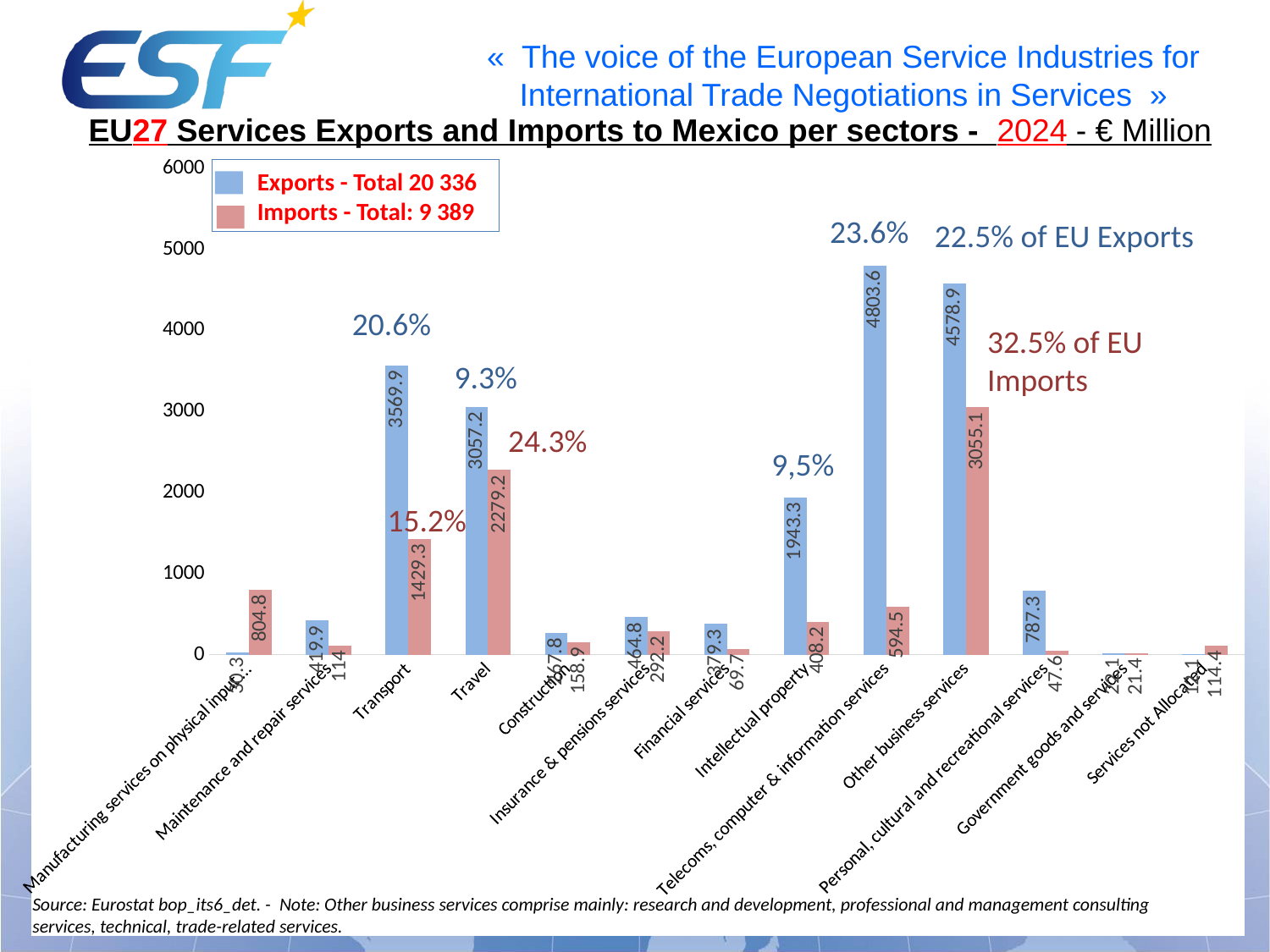
What type of chart is shown on the slide? bar chart For Travel, which is larger: Exports or Imports? Exports Which sector has the highest Imports value? Other business services What is the value of Imports for Other business services? 3055.1 What is the value of Exports for Transport? 3569.9 How many sectors are shown on the x axis? 13 What is the value of Exports for Intellectual property? 1943.3 What is the difference between Exports and Imports for Transport? 2140.6 Which sector has the highest Exports value? Telecoms, computer & information services How many series does the legend list? 2 Is the Exports value for Personal, cultural and recreational services greater or less than 1000? less What is the value of Imports for Travel? 2279.2